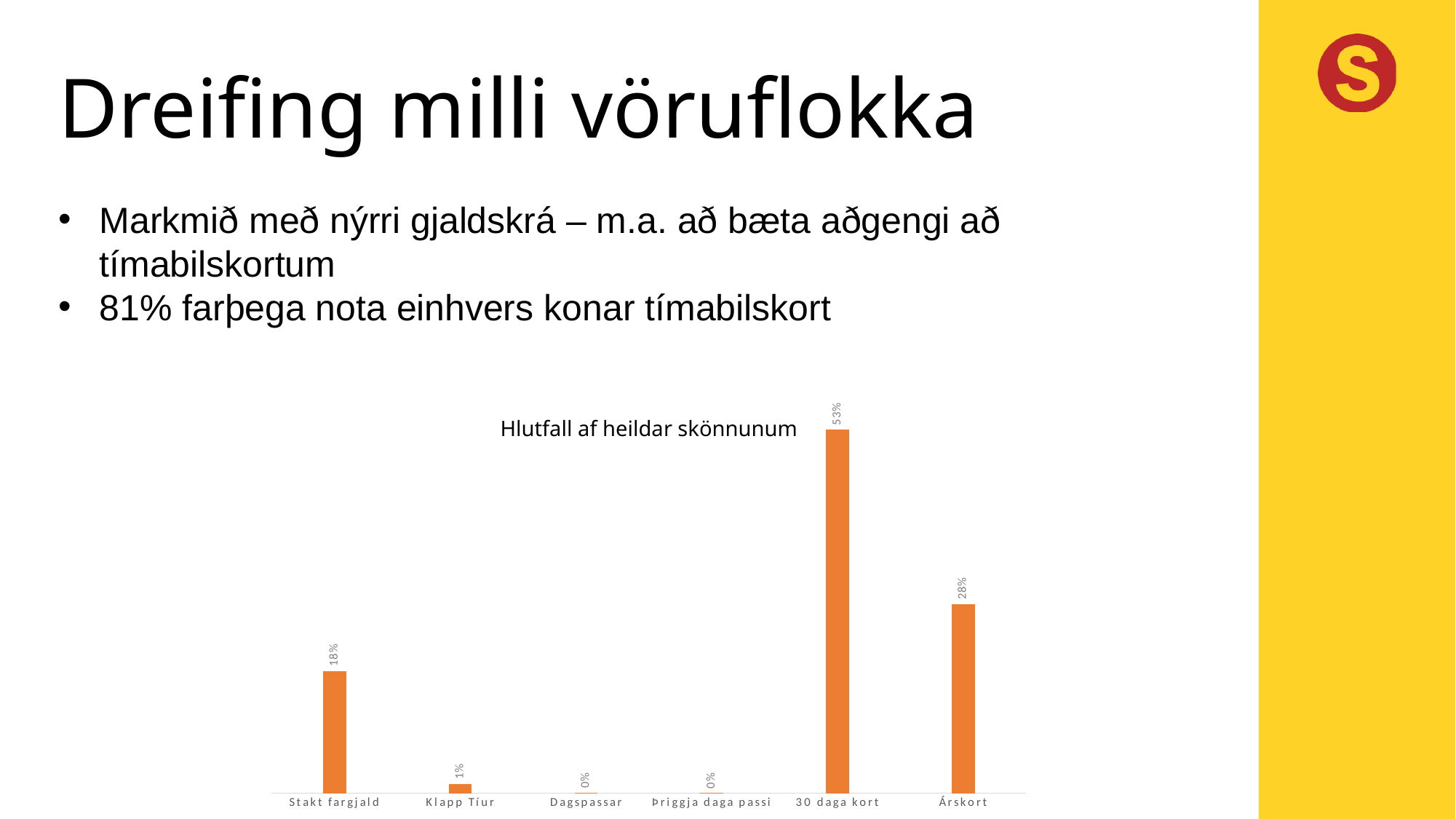
What is the title of the chart? Hlutfall af heildar skönnunum What is the value for Árskort in the chart? 28% What colour are the bars in the chart? orange What is the value for 30 daga kort in the chart? 53% What is the difference between the values for 30 daga kort and Árskort? 25% What is the difference between the values for Árskort and Stakt fargjald? 10% How many categories are shown on the x axis of the chart? 6 What is the value for Stakt fargjald in the chart? 18% Which is larger, the value for Stakt fargjald or the value for Árskort? Árskort Which category has the highest value in the chart? 30 daga kort What kind of chart is shown on the slide? bar chart What is the value for Klapp Tíur in the chart? 1%